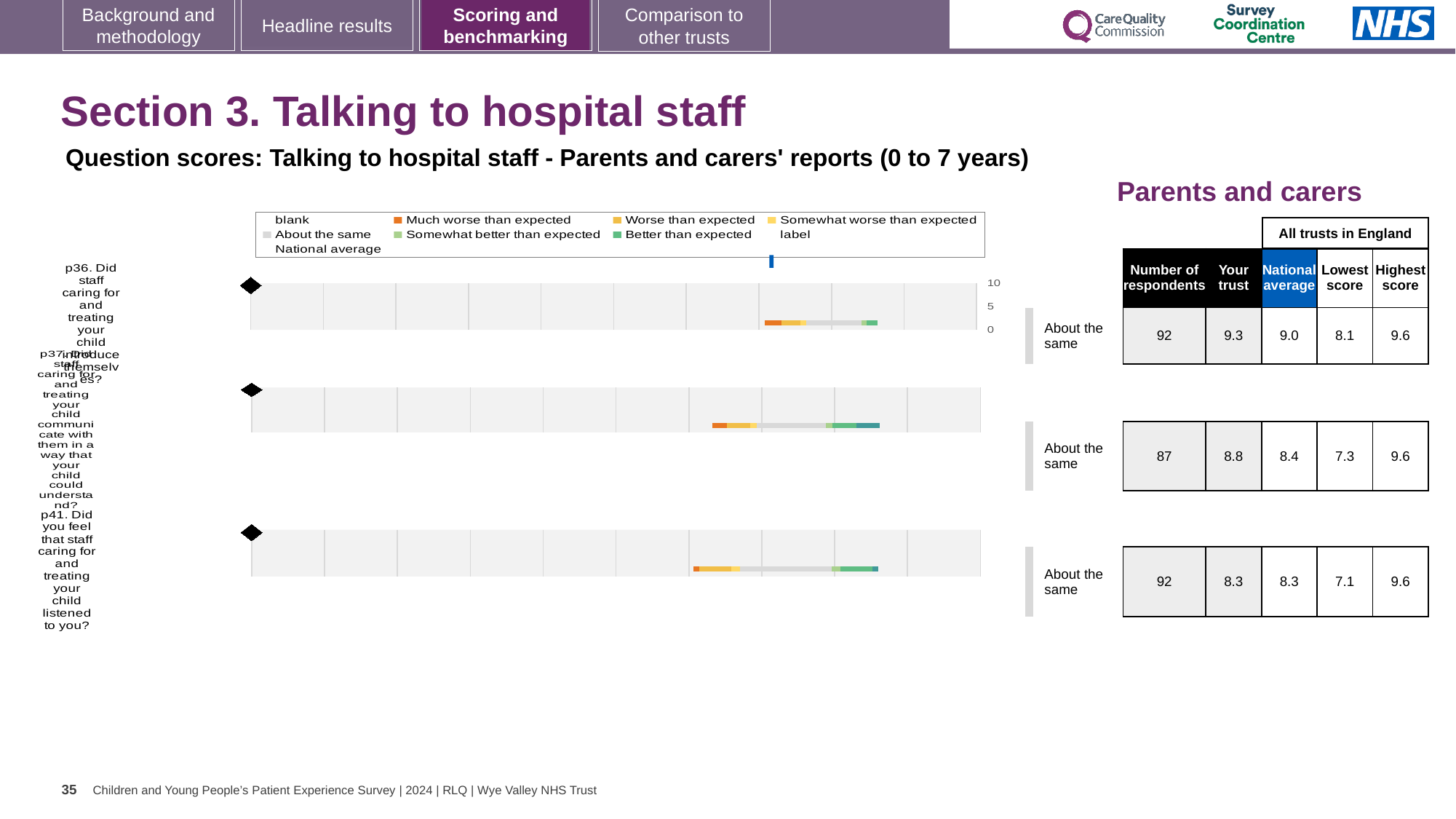
What benchmark category is shown for question p41? About the same In the chart legend, what does the orange entry represent? Much worse than expected What kind of chart is used to show the question scores on this slide? bar chart How many survey questions (p36, p37, p41) are plotted as separate charts on this slide? 3 How many respondents answered question p41 (Did you feel that staff listened to you?)? 92 For question p36, which is higher: the 'Your trust' score or the National average? Your trust For question p37, what is the difference between the 'Your trust' score and the National average? 0.4 For question p36 (Did staff caring for and treating your child introduce themselves?), what is the 'Your trust' score shown in the table? 9.3 What is the Lowest score among all trusts in England for question p37? 7.3 Which question has the highest 'Your trust' score on this slide? p36 What is the highest tick value shown on the vertical axis of the charts? 10 For question p37 (Did staff communicate with your child in a way they could understand?), what is the National average score? 8.4